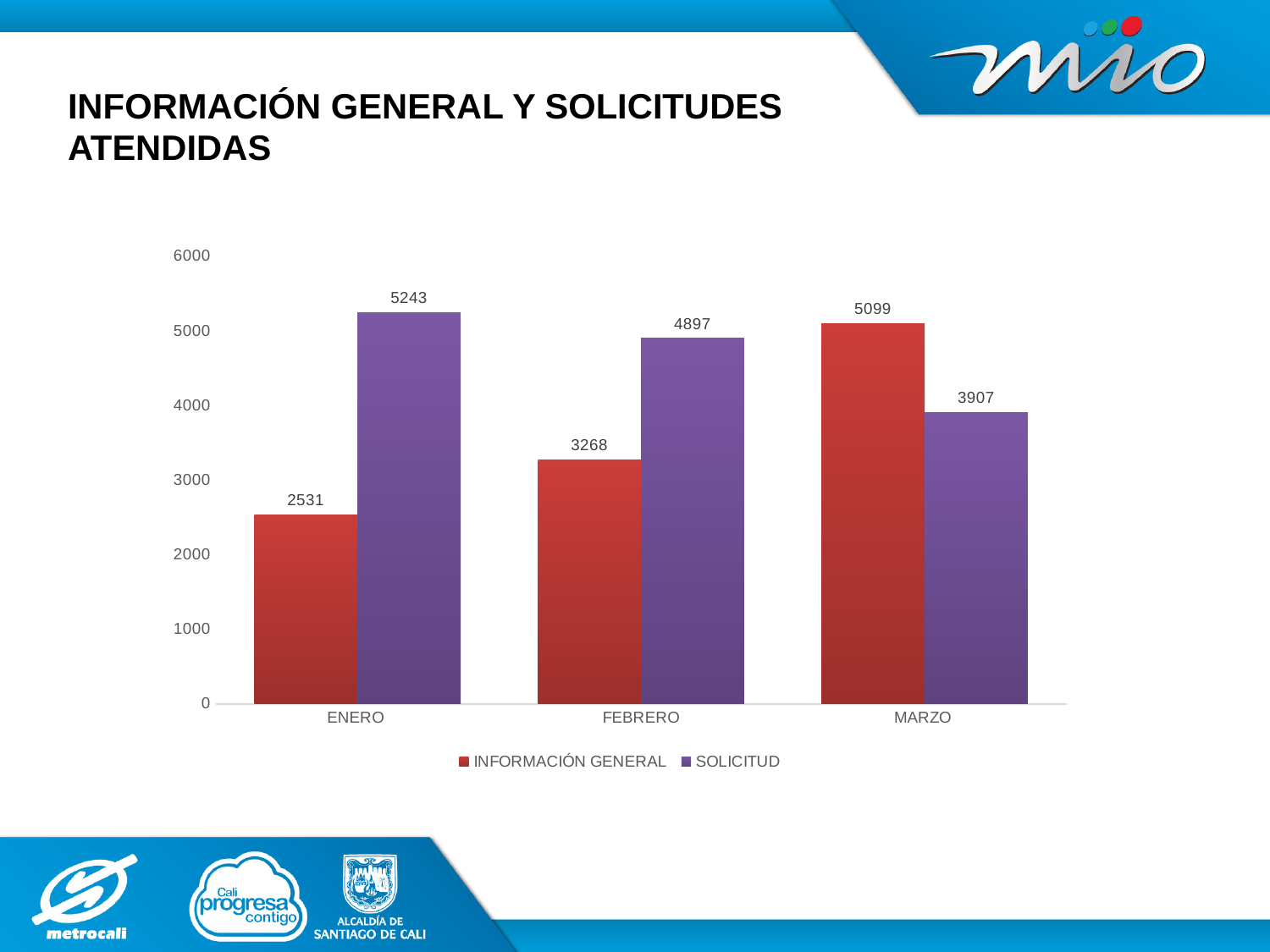
What is the value for SOLICITUD in MARZO? 3907 Does the value for INFORMACIÓN GENERAL rise or fall from ENERO to MARZO? rise Which is larger in MARZO, INFORMACIÓN GENERAL or SOLICITUD? INFORMACIÓN GENERAL What is the value for SOLICITUD in FEBRERO? 4897 What kind of chart is shown on the slide? bar chart Which month has the lowest value for SOLICITUD? MARZO How many months are shown on the x axis? 3 What is the difference between SOLICITUD and INFORMACIÓN GENERAL in ENERO? 2712 Is the value for INFORMACIÓN GENERAL in FEBRERO greater or less than 3000? greater What is the value for INFORMACIÓN GENERAL in ENERO? 2531 How many series does the legend list? 2 Which month has the highest value for INFORMACIÓN GENERAL? MARZO